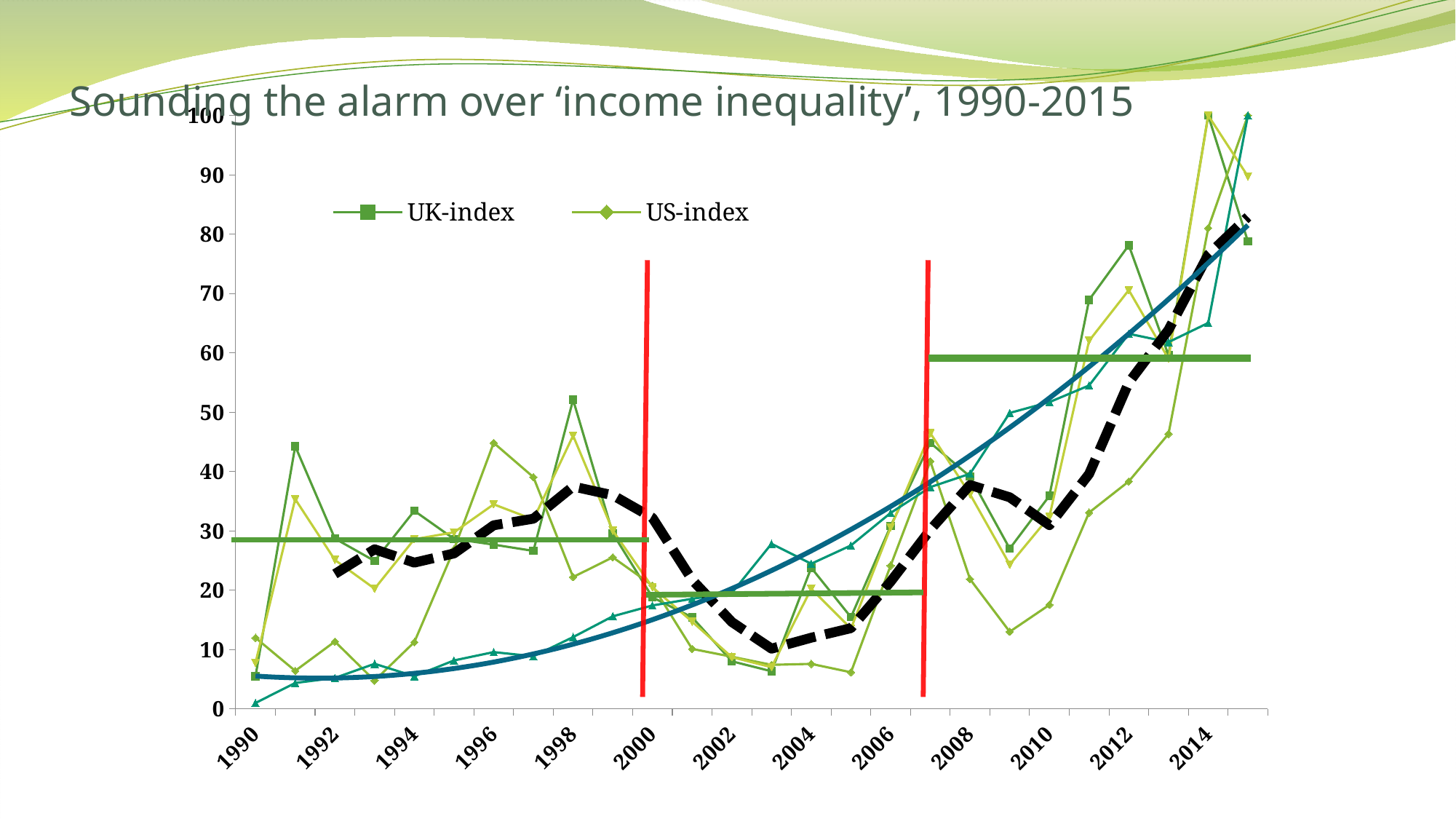
How many year labels are shown on the x axis? 13 Which two series are named in the legend? UK-index and US-index What kind of chart is shown on the slide? line chart Is the UK-index value for 2003 greater or less than 10? less Which is larger for the UK-index: the value in 1998 or the value in 2003? 1998 Is the UK-index value for 2011 greater or less than 60? greater Is the UK-index value for 1991 greater or less than 40? greater Which is larger for the UK-index: the value in 1990 or the value in 2012? 2012 How many series does the legend list? 2 Do the UK-index values generally rise or fall between 2003 and 2015? rise What is the title of the chart? Sounding the alarm over 'income inequality', 1990-2015